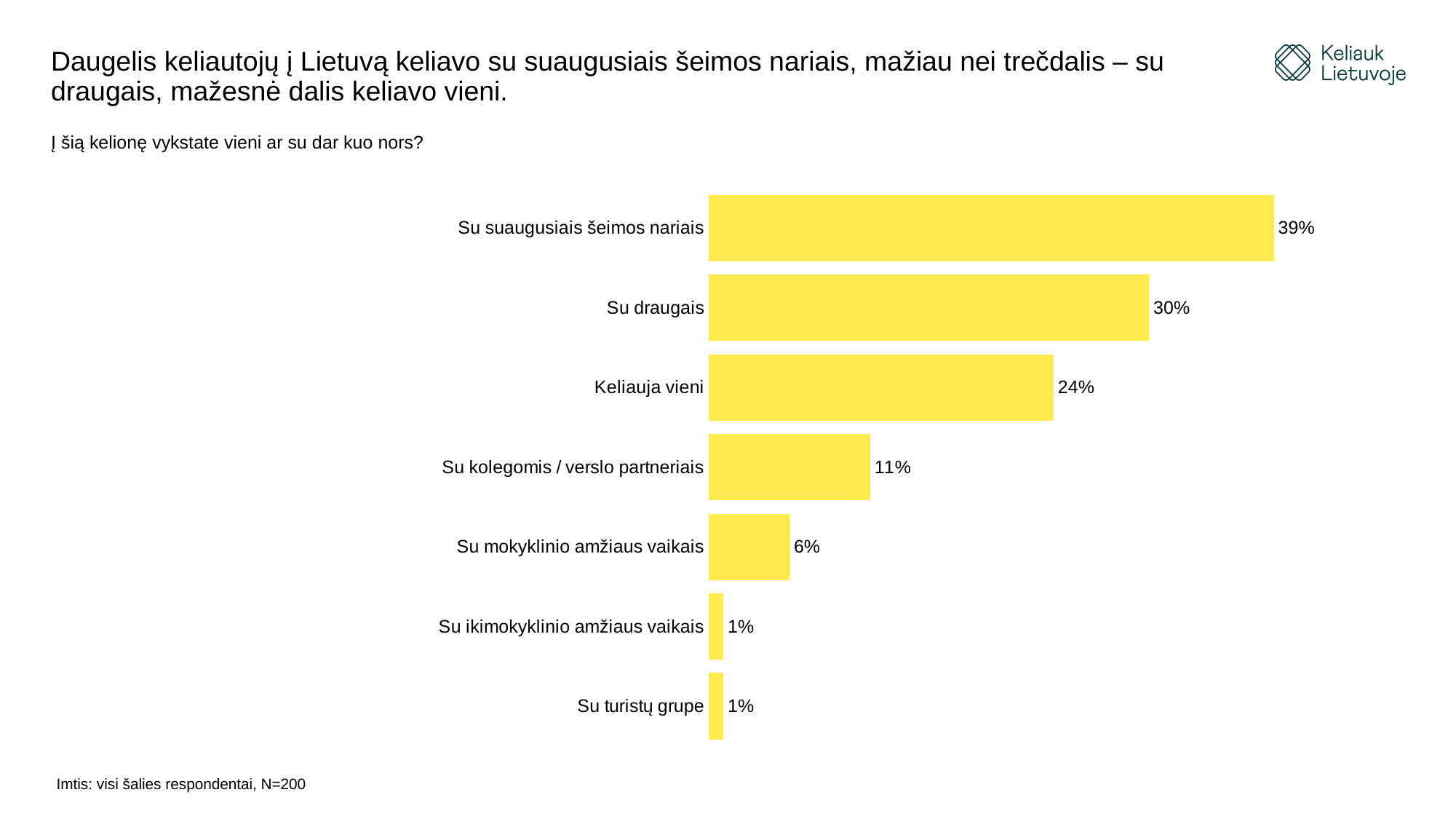
What is the difference between the values for "Su suaugusiais šeimos nariais" and "Su draugais"? 9% What is the value for "Keliauja vieni"? 24% What is the difference between the values for "Keliauja vieni" and "Su kolegomis / verslo partneriais"? 13% Which category has the highest value? Su suaugusiais šeimos nariais What is the value for "Su suaugusiais šeimos nariais"? 39% What is the value for "Su kolegomis / verslo partneriais"? 11% What is the sample size stated at the bottom of the slide? N=200 How many categories are shown in the chart? 7 What is the value for "Su mokyklinio amžiaus vaikais"? 6% What is the value for "Su draugais"? 30% Which is larger, the value for "Su draugais" or the value for "Keliauja vieni"? Su draugais What kind of chart is shown on the slide? Bar chart